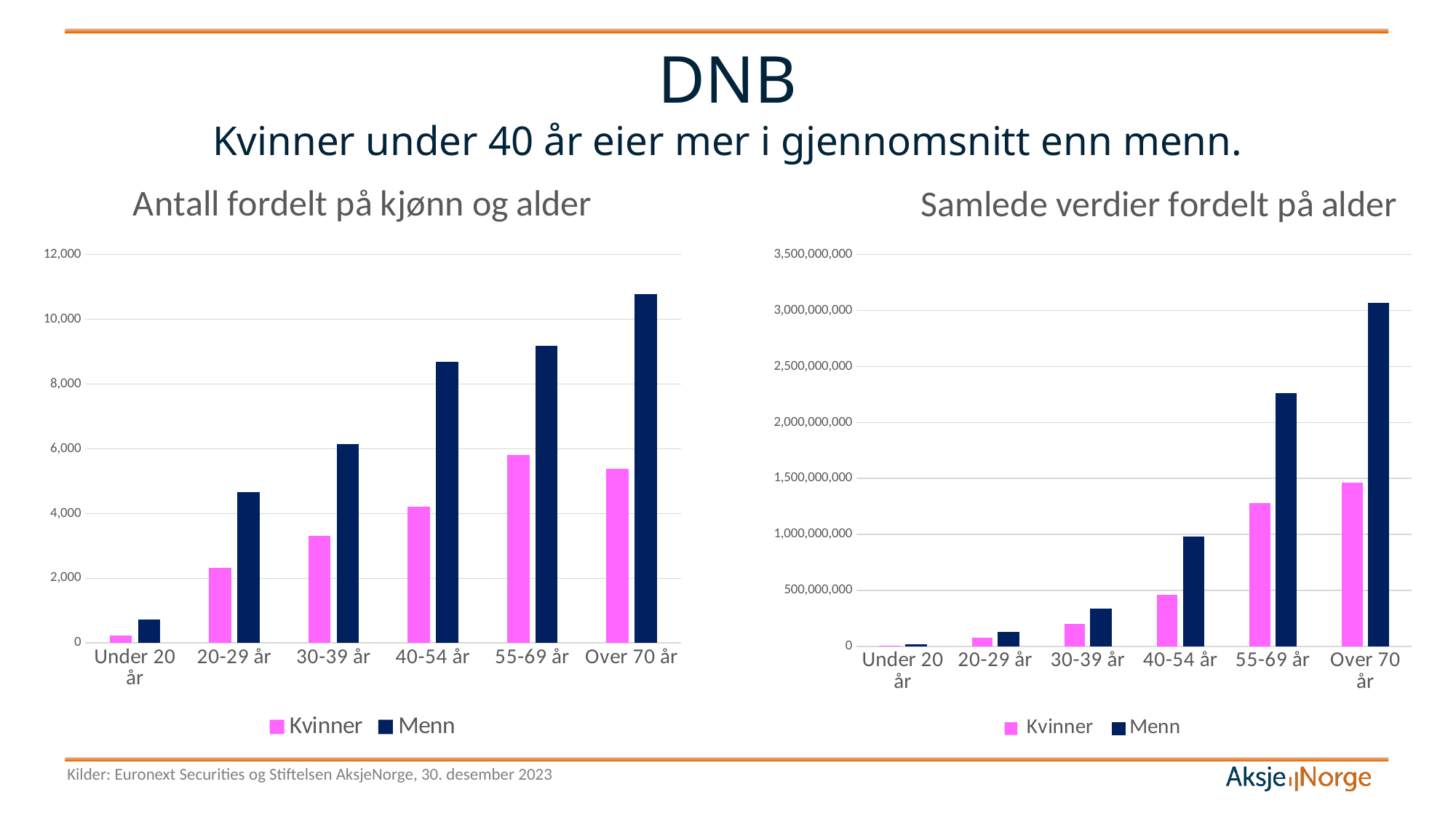
In the chart 'Samlede verdier fordelt på alder', is the value for Menn in the 55-69 år group greater or less than 2,000,000,000? greater In the chart 'Antall fordelt på kjønn og alder', which age group has the lowest value for Kvinner? Under 20 år In the chart 'Antall fordelt på kjønn og alder', which age group has the highest value for Menn? Over 70 år In the chart 'Samlede verdier fordelt på alder', which age group has the highest value for Menn? Over 70 år In the chart 'Antall fordelt på kjønn og alder', is the value for Menn in the 40-54 år group greater or less than 8,000? greater What kind of chart is 'Samlede verdier fordelt på alder'? Bar chart How many series does the legend of the chart 'Samlede verdier fordelt på alder' list? 2 In the chart 'Samlede verdier fordelt på alder', which colour represents Kvinner? Pink In the chart 'Samlede verdier fordelt på alder', do the values for Menn rise or fall as the age groups move from Under 20 år to Over 70 år? Rise In the chart 'Antall fordelt på kjønn og alder', is the value for Kvinner in the 30-39 år group greater or less than 4,000? less In the chart 'Antall fordelt på kjønn og alder', which is larger for the 20-29 år group, Kvinner or Menn? Menn How many age groups are shown in the chart 'Antall fordelt på kjønn og alder'? 6